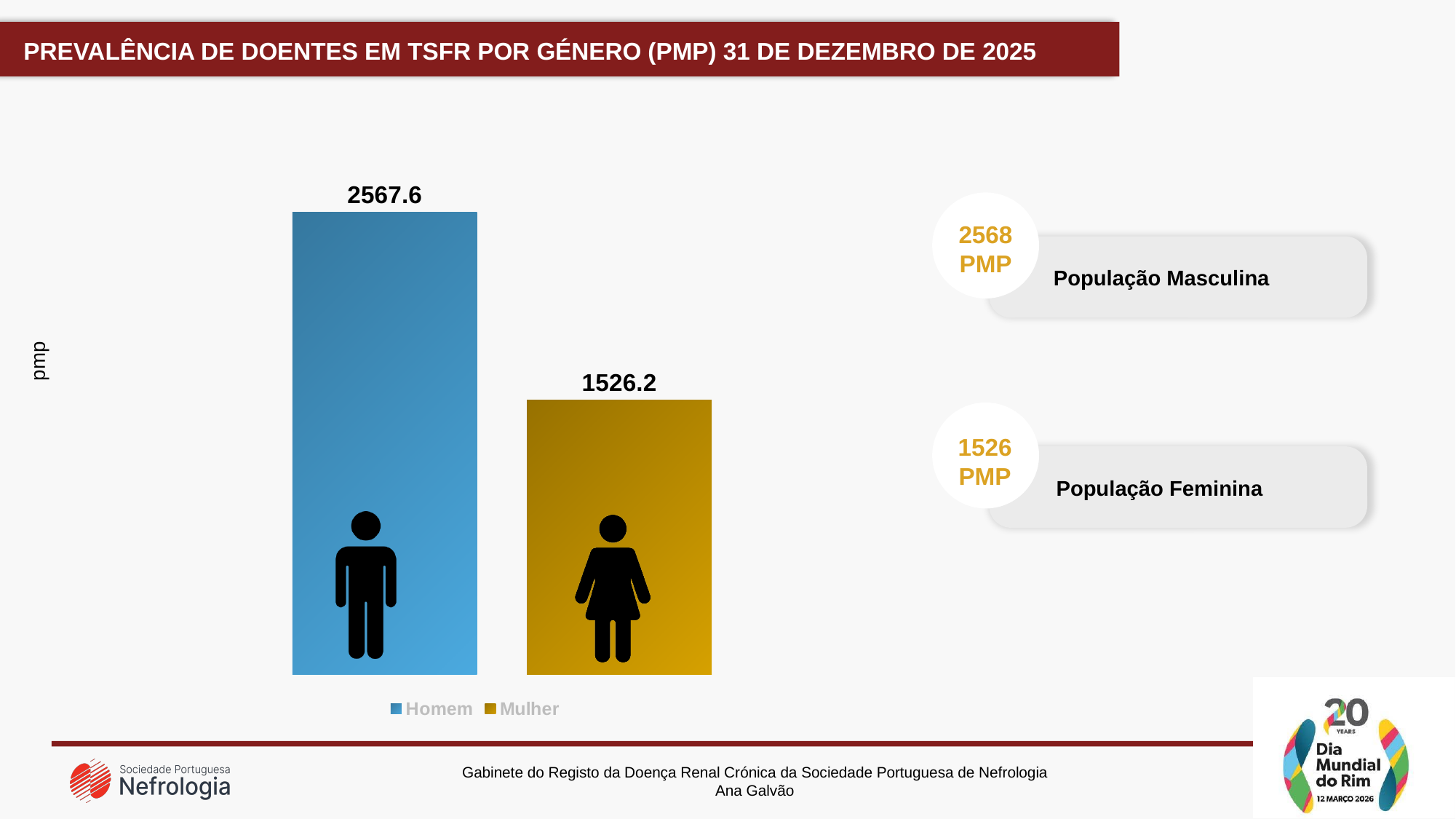
Which series has the lowest value? Mulher How many bars are plotted in the chart? 2 What is the value for Homem? 2567.6 What kind of chart is shown on the slide? Bar chart How many series does the legend list? 2 What colour is the Mulher bar? Yellow/gold Which is larger, the value for Homem or the value for Mulher? Homem What is the difference between the Homem and Mulher values? 1041.4 What is the label on the vertical axis of the chart? pmp Which series has the highest value? Homem What is the value for Mulher? 1526.2